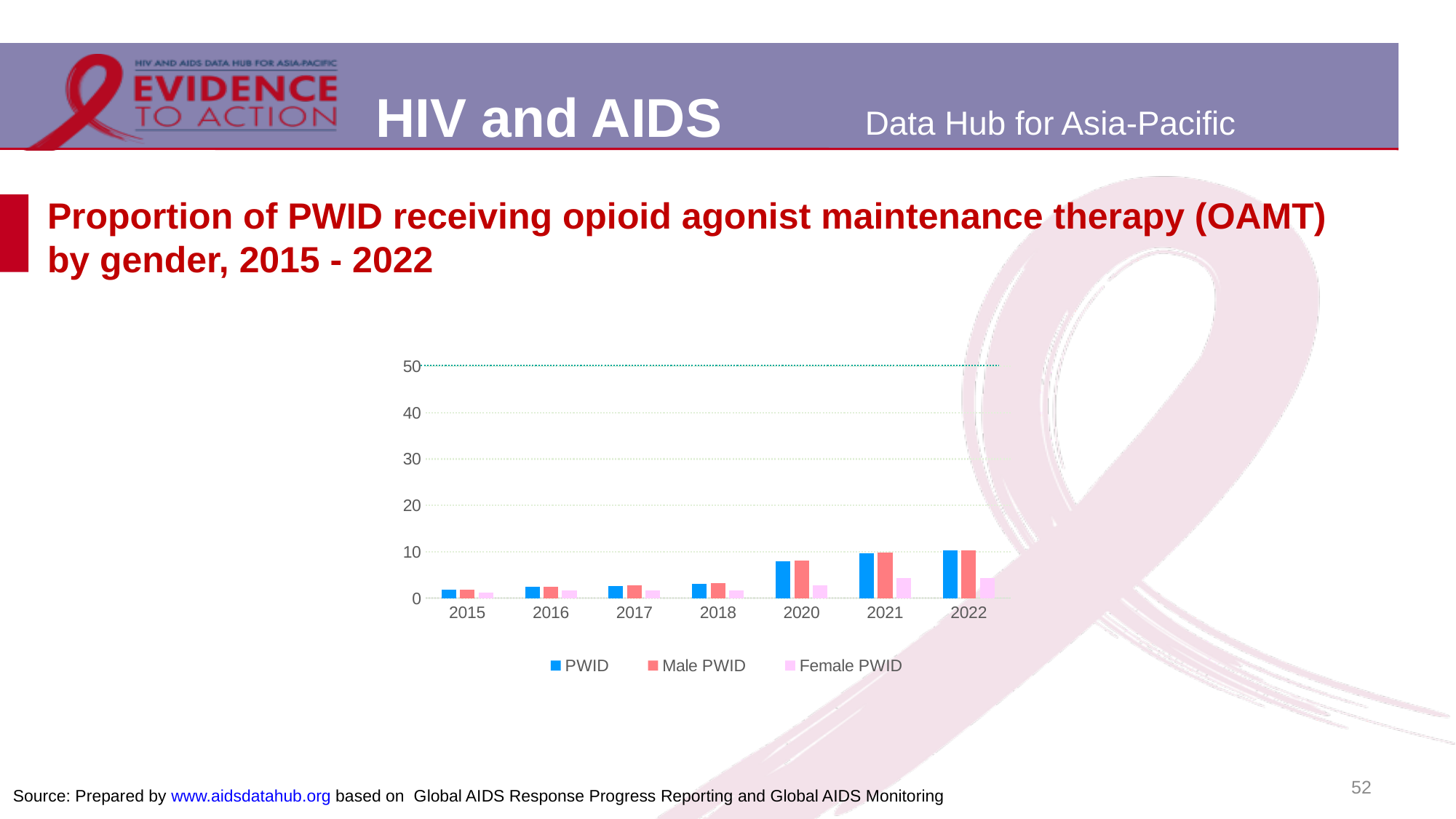
What kind of chart is shown on the slide? bar chart How many series does the legend list? 3 How many years are shown on the x axis? 7 Which series are listed in the legend? PWID, Male PWID, Female PWID In 2022, which is larger: Male PWID or Female PWID? Male PWID Is the value for Female PWID in 2022 greater or less than 10? less Is the value for Male PWID in 2021 greater or less than 20? less Do the PWID values generally rise or fall from 2015 to 2022? rise What is the highest value shown on the y axis? 50 Is the value for PWID in 2020 greater or less than 10? less Which is larger: PWID in 2015 or PWID in 2022? PWID in 2022